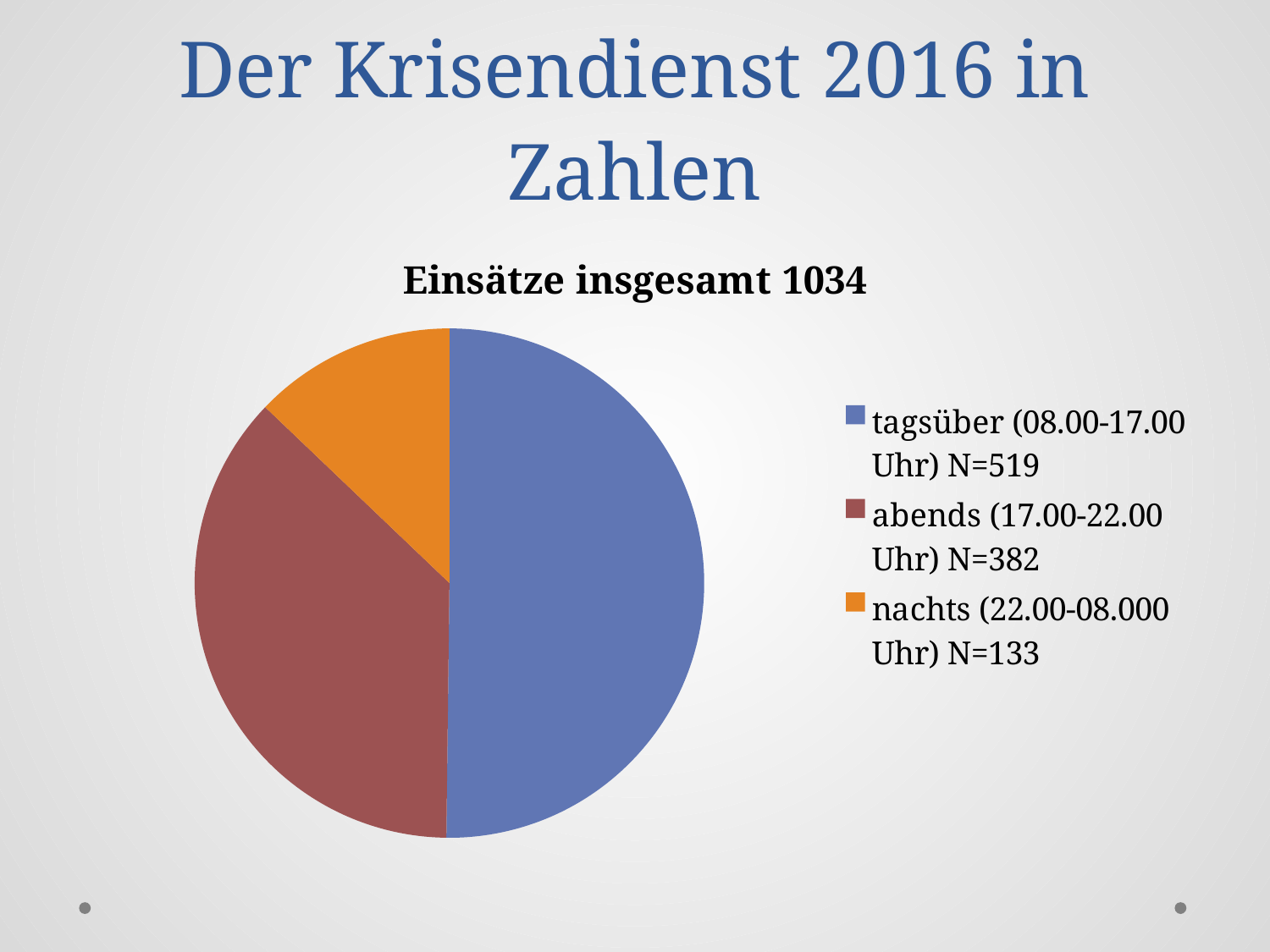
How many slices does the pie chart have? 3 What is the title of the chart? Einsätze insgesamt 1034 What is the difference between the number of Einsätze tagsüber and abends? 137 Which time period has the smallest slice of the pie? nachts (22.00-08.000 Uhr) What kind of chart is shown on the slide? pie chart How many entries does the legend list? 3 What is the number of Einsätze for abends (17.00-22.00 Uhr)? 382 What is the number of Einsätze for nachts (22.00-08.000 Uhr)? 133 What is the difference between the number of Einsätze abends and nachts? 249 Which time period has the largest slice of the pie? tagsüber (08.00-17.00 Uhr) What is the number of Einsätze for tagsüber (08.00-17.00 Uhr)? 519 Which is larger, the number of Einsätze abends or nachts? abends